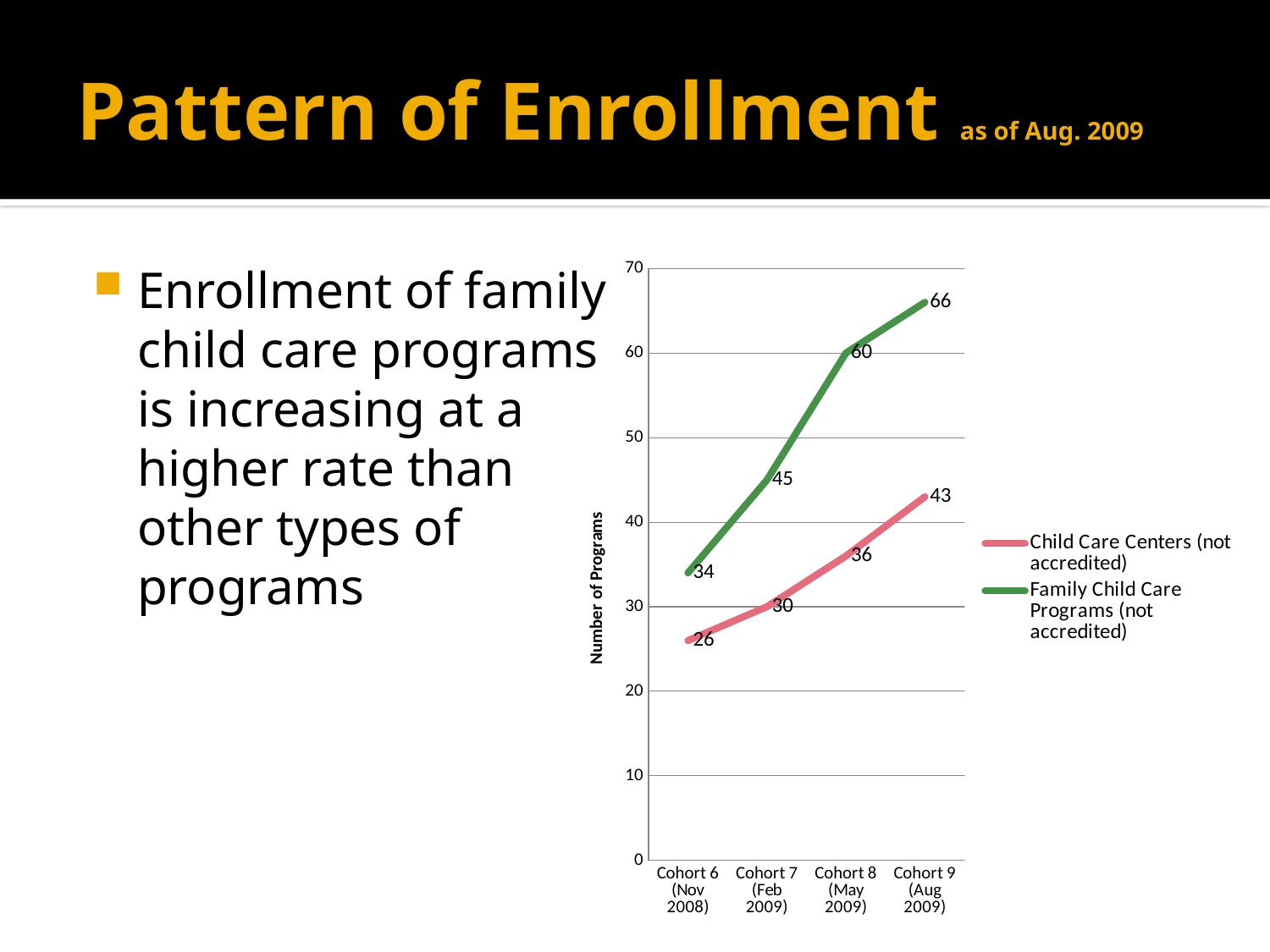
What is the difference between Family Child Care Programs and Child Care Centers at Cohort 9 (Aug 2009)? 23 How many cohorts are shown on the x axis? 4 What is the number of Family Child Care Programs (not accredited) at Cohort 9 (Aug 2009)? 66 At which cohort is the number of Child Care Centers (not accredited) lowest? Cohort 6 (Nov 2008) How many series does the legend list? 2 What is the number of Child Care Centers (not accredited) at Cohort 6 (Nov 2008)? 26 What is the number of Family Child Care Programs (not accredited) at Cohort 7 (Feb 2009)? 45 What kind of chart is shown on the slide? Line chart At which cohort is the number of Family Child Care Programs (not accredited) highest? Cohort 9 (Aug 2009) Which series has the larger value at Cohort 8 (May 2009)? Family Child Care Programs (not accredited) By how much did the number of Family Child Care Programs (not accredited) increase from Cohort 6 to Cohort 9? 32 What is the number of Child Care Centers (not accredited) at Cohort 8 (May 2009)? 36